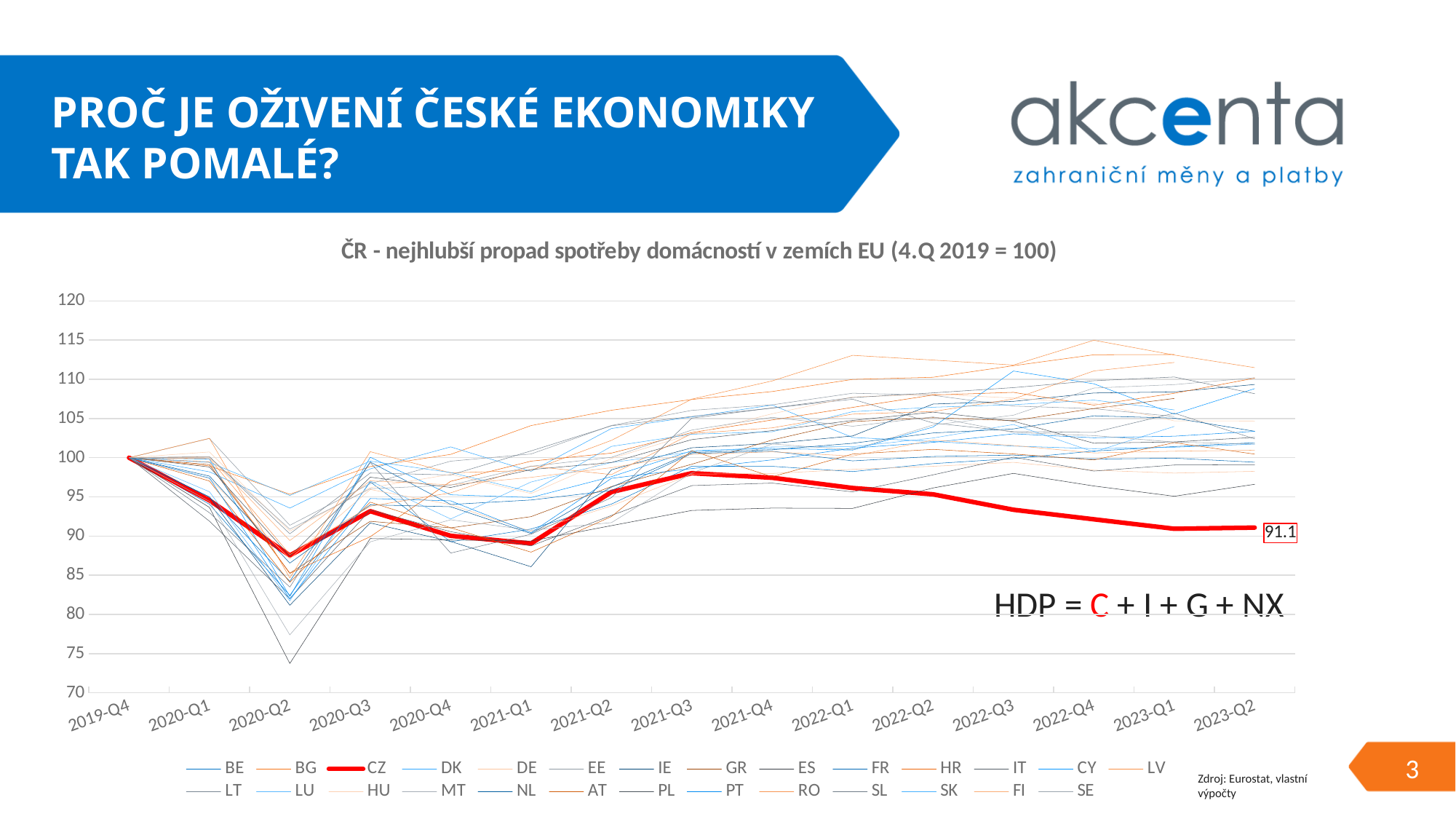
Is the value for CZ at 2021-Q3 greater or less than 95? greater What is the value of the CZ series at 2019-Q4? 100 Is the value for CZ at 2020-Q2 greater or less than 90? less In which quarter does the CZ series reach its lowest value? 2020-Q2 How many quarters are shown on the x axis? 15 What kind of chart is shown on the slide? line chart Does the CZ series rise or fall from 2021-Q3 to 2023-Q2? fall Is the value for CZ at 2023-Q2 greater or less than 95? less How many series does the legend list? 27 Which series is drawn as the thick red line? CZ What is the title of the chart? ČR - nejhlubší propad spotřeby domácností v zemích EU (4.Q 2019 = 100) What is the value of the CZ series at 2023-Q2? 91.1